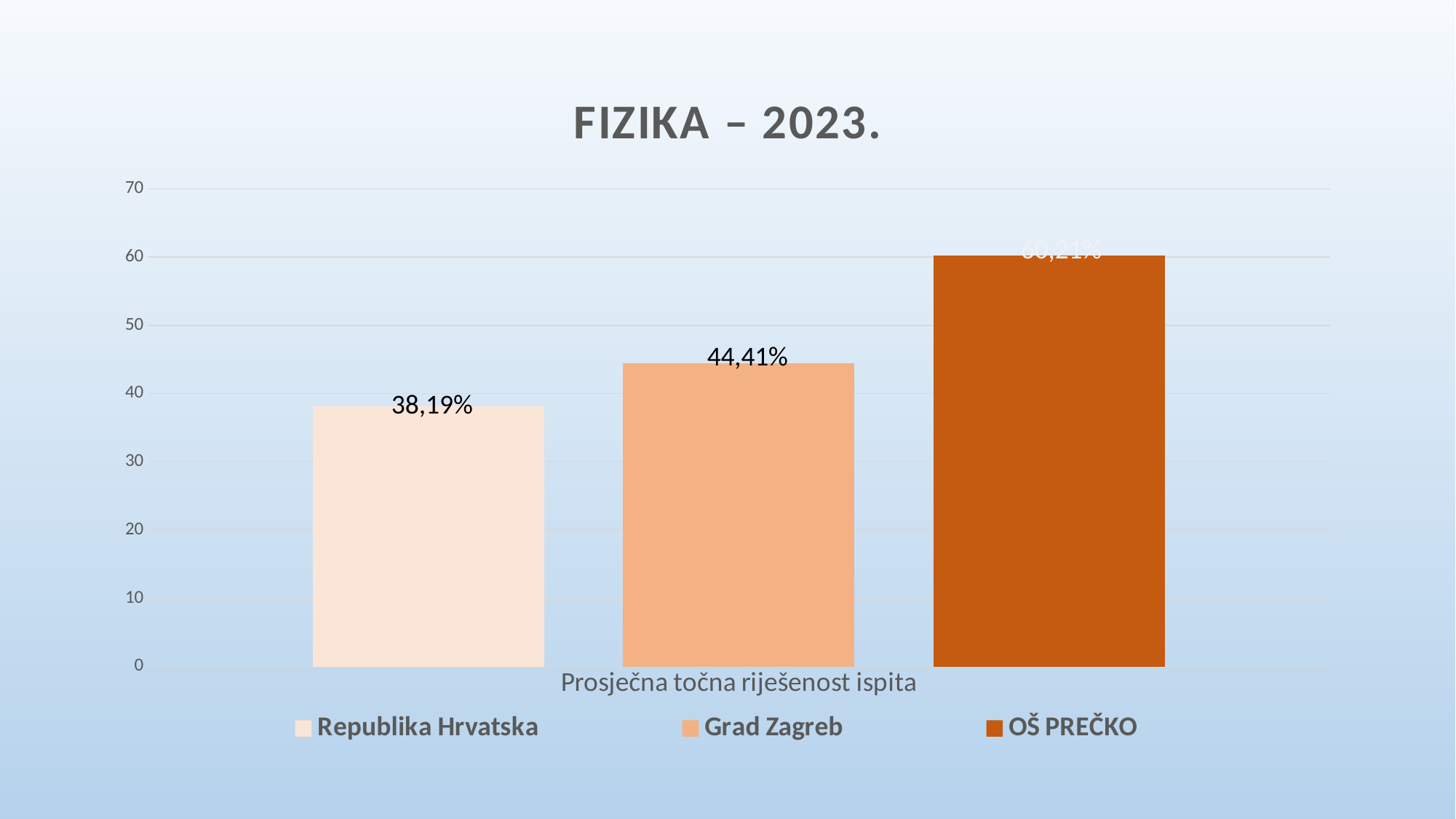
What is the value for Republika Hrvatska? 38,19% What is the title of the chart? FIZIKA – 2023. What is the difference between the values for Grad Zagreb and Republika Hrvatska? 6,22% Is the value for OŠ PREČKO greater or less than 50? greater What is the difference between the values for OŠ PREČKO and Grad Zagreb? 15,80% How many series does the legend list? 3 Which series has the lowest value? Republika Hrvatska What is the value for OŠ PREČKO? 60,21% Which series has the highest value? OŠ PREČKO Which is larger, the value for Grad Zagreb or the value for Republika Hrvatska? Grad Zagreb What kind of chart is shown on the slide? Bar chart What is the value for Grad Zagreb? 44,41%